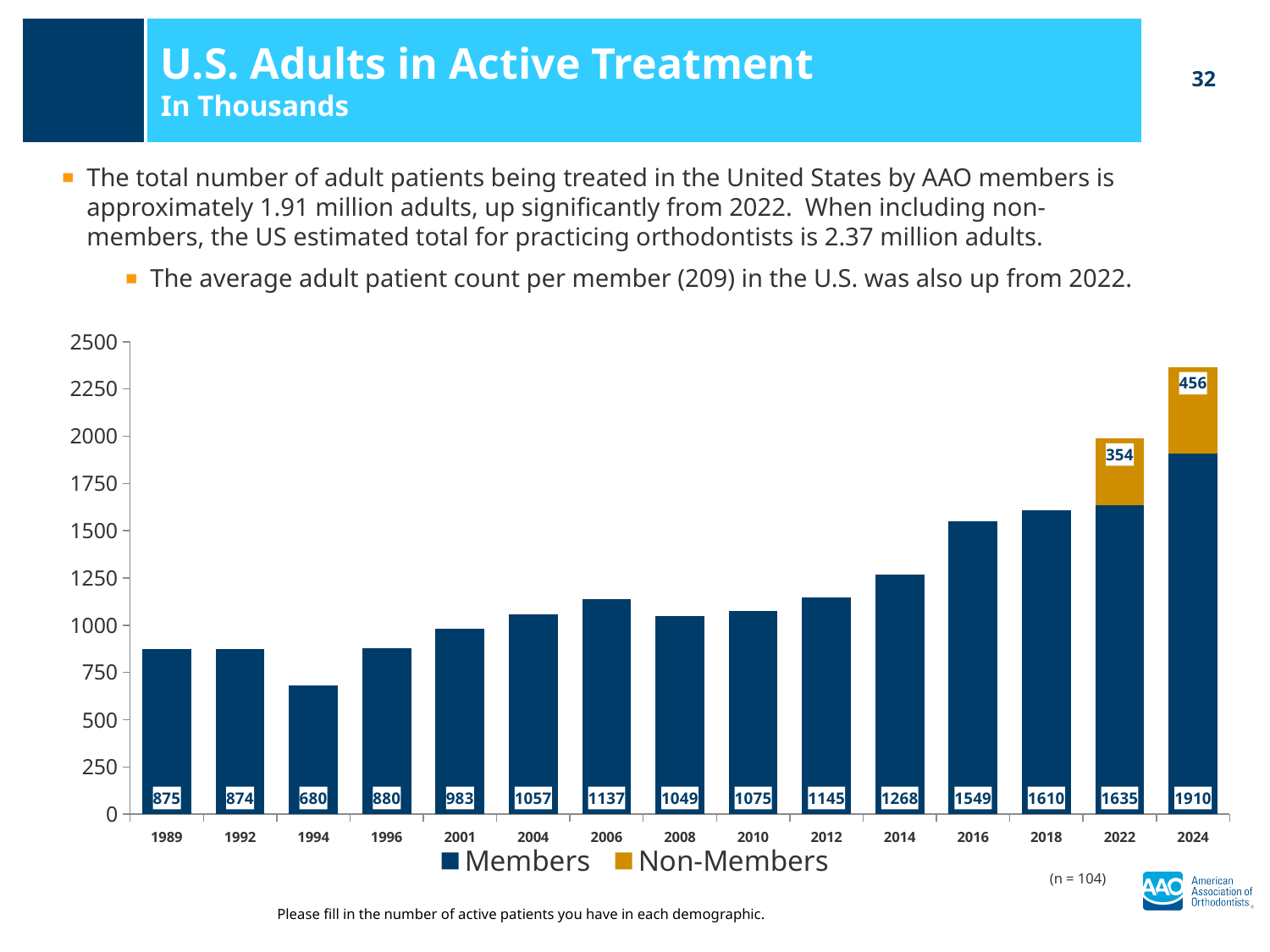
Which year has the lowest Members value? 1994 What is the total of the stacked bar for 2024? 2366 What is the Non-Members value for 2022? 354 What is the total of the stacked bar for 2022? 1989 Which is larger, the Members value for 2006 or for 2008? 2006 What is the Members value for 1994? 680 How many series does the legend list? 2 How many years are shown on the x axis? 15 What kind of chart is shown on the slide? Stacked bar chart What is the Members value for 2024? 1910 What is the difference between the Members values for 2024 and 2022? 275 Which year has the highest Members value? 2024